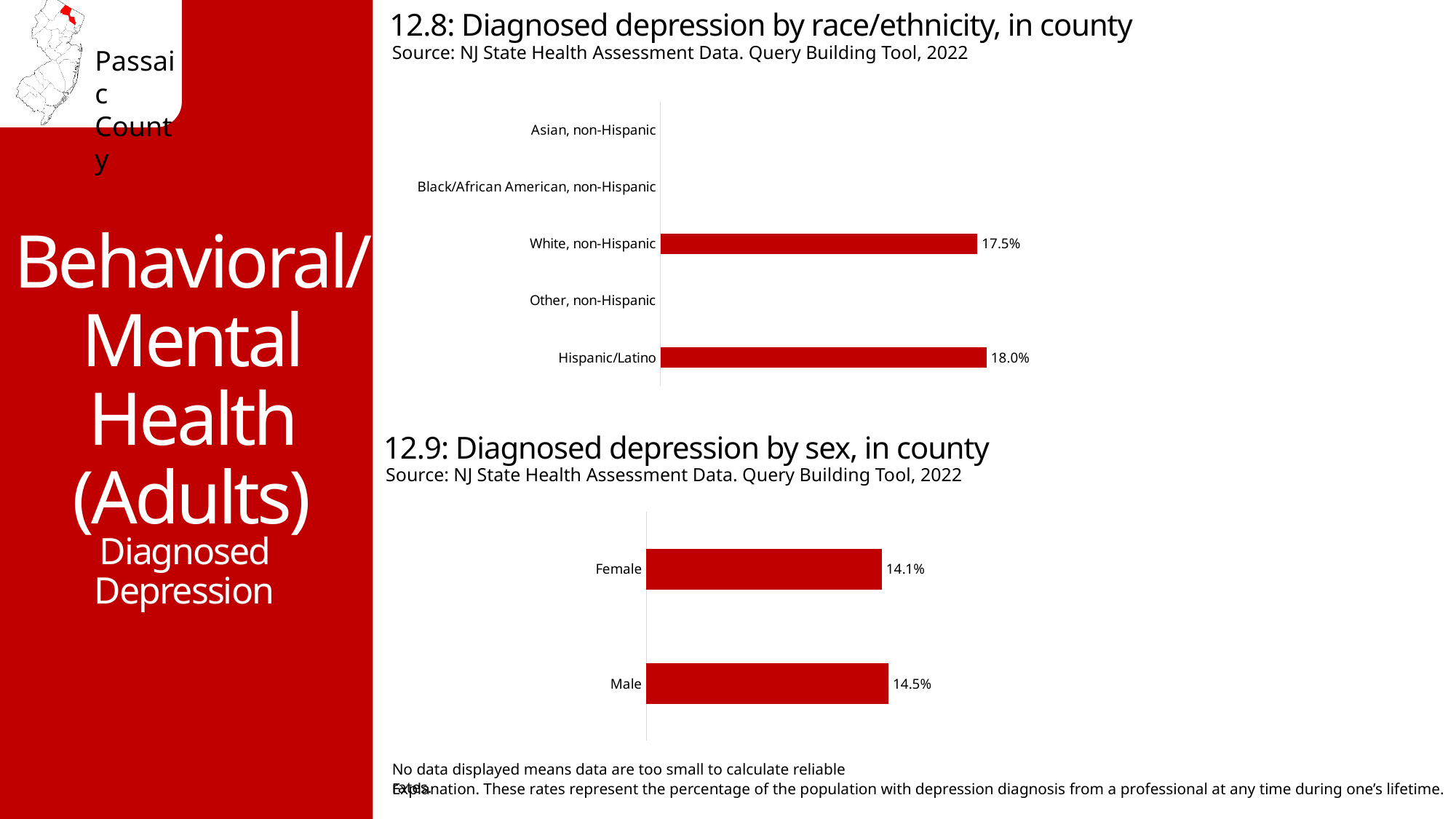
In the chart '12.8: Diagnosed depression by race/ethnicity, in county', how many categories are listed on the axis? 5 In the chart '12.8: Diagnosed depression by race/ethnicity, in county', what is the value for White, non-Hispanic? 17.5% In the chart '12.8: Diagnosed depression by race/ethnicity, in county', how many categories have a bar displayed? 2 In the chart '12.9: Diagnosed depression by sex, in county', what is the difference between the Male and Female values? 0.4% In the chart '12.8: Diagnosed depression by race/ethnicity, in county', which category has the highest value? Hispanic/Latino What is the source cited for the chart '12.9: Diagnosed depression by sex, in county'? NJ State Health Assessment Data. Query Building Tool, 2022 In the chart '12.8: Diagnosed depression by race/ethnicity, in county', what is the difference between the Hispanic/Latino and White, non-Hispanic values? 0.5% In the chart '12.8: Diagnosed depression by race/ethnicity, in county', what is the value for Hispanic/Latino? 18.0% In the chart '12.9: Diagnosed depression by sex, in county', which is larger, the Male or Female value? Male What kind of chart is '12.8: Diagnosed depression by race/ethnicity, in county'? Bar chart In the chart '12.9: Diagnosed depression by sex, in county', what is the value for Male? 14.5% In the chart '12.9: Diagnosed depression by sex, in county', what is the value for Female? 14.1%